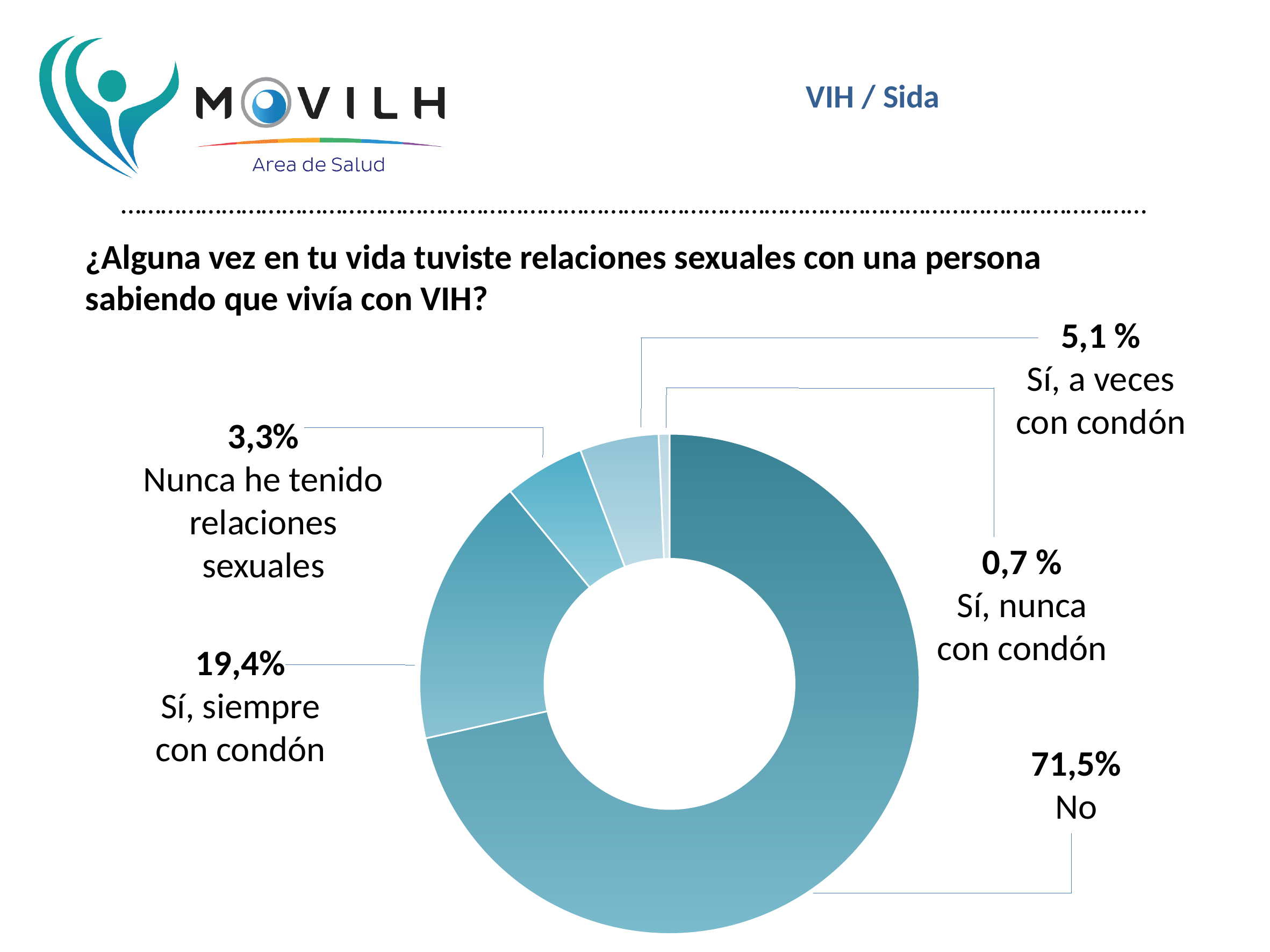
Which response has the largest share of the chart? No Which is larger: the share for "Sí, a veces con condón" or for "Nunca he tenido relaciones sexuales"? Sí, a veces con condón What percentage of respondents answered "Sí, a veces con condón"? 5,1 % What question does the chart on the slide answer? ¿Alguna vez en tu vida tuviste relaciones sexuales con una persona sabiendo que vivía con VIH? What percentage of respondents answered "No"? 71,5% What is the difference in percentage points between "No" and "Sí, siempre con condón"? 52,1 How many response categories are shown in the chart? 5 What kind of chart is shown on the slide? Doughnut (pie) chart What percentage of respondents answered "Sí, nunca con condón"? 0,7 % What percentage of respondents answered "Sí, siempre con condón"? 19,4% What percentage of respondents answered "Nunca he tenido relaciones sexuales"? 3,3% Which response has the smallest share of the chart? Sí, nunca con condón